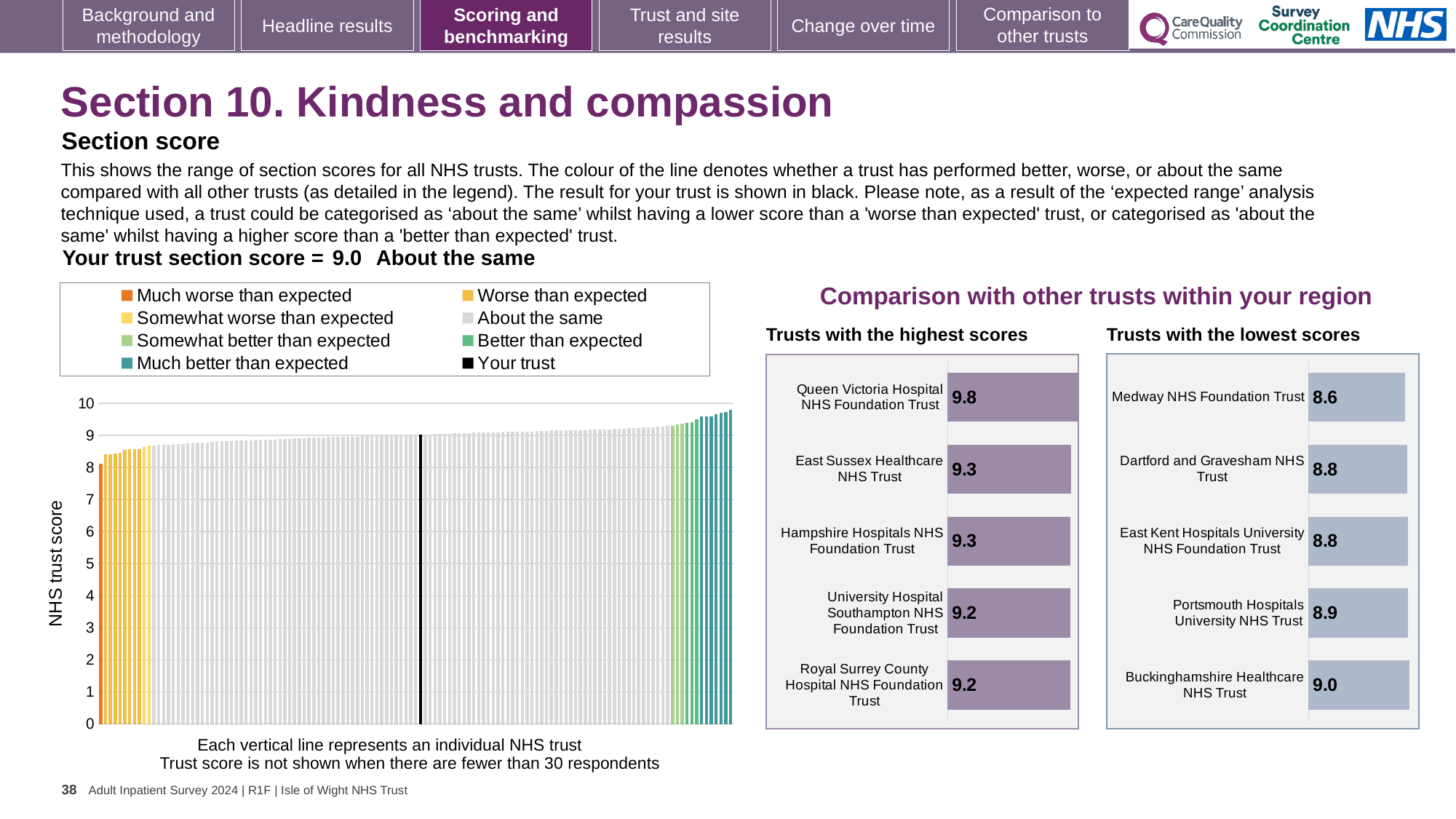
In the 'Trusts with the highest scores' chart, what is the score for Queen Victoria Hospital NHS Foundation Trust? 9.8 In the large 'NHS trust score' chart on the left, what is the section score for your trust (the black line)? 9.0 In the 'Trusts with the highest scores' chart, which trust has the highest score? Queen Victoria Hospital NHS Foundation Trust In the 'Trusts with the lowest scores' chart, which has the higher score: Portsmouth Hospitals University NHS Trust or Dartford and Gravesham NHS Trust? Portsmouth Hospitals University NHS Trust In the 'Trusts with the highest scores' chart, what is the difference between the scores of Queen Victoria Hospital NHS Foundation Trust and Royal Surrey County Hospital NHS Foundation Trust? 0.6 What kind of chart is the large 'NHS trust score' chart on the left of the slide? Bar chart How many entries does the legend of the large 'NHS trust score' chart on the left list? 8 In the 'Trusts with the lowest scores' chart, what is the score for Medway NHS Foundation Trust? 8.6 In the large 'NHS trust score' chart on the left, do the values rise or fall from left to right? Rise In the 'Trusts with the lowest scores' chart, which trust has the lowest score? Medway NHS Foundation Trust How many trusts are shown in the 'Trusts with the highest scores' chart? 5 In the 'Trusts with the lowest scores' chart, what is the score for Buckinghamshire Healthcare NHS Trust? 9.0